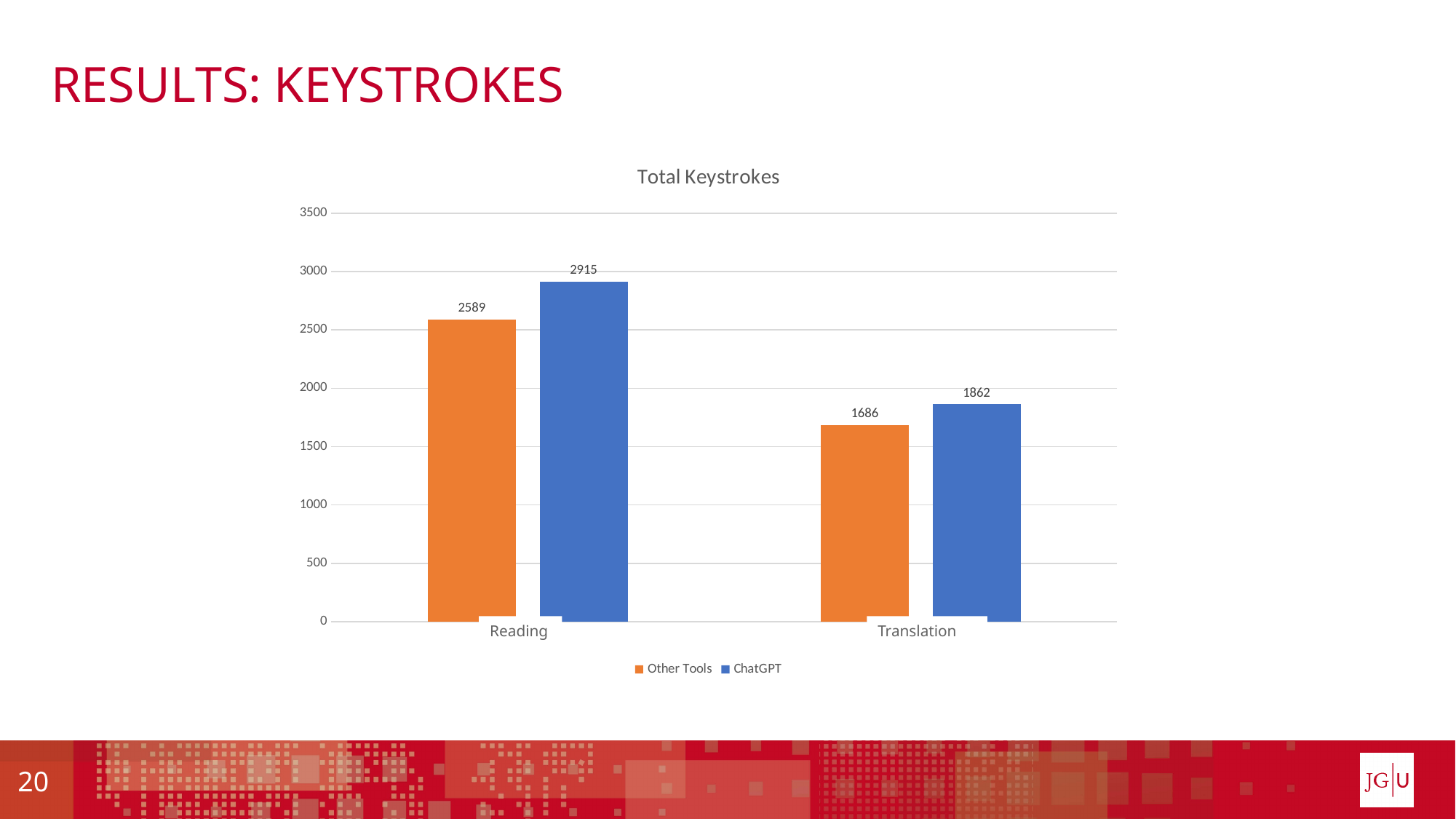
Which is larger in the Translation category, Other Tools or ChatGPT? ChatGPT What is the difference between ChatGPT and Other Tools in the Translation category? 176 What is the value for Other Tools in the Reading category? 2589 What is the value for Other Tools in the Translation category? 1686 What is the difference between ChatGPT and Other Tools in the Reading category? 326 How many series does the legend list? 2 What type of chart is shown on the slide? Bar chart Which bar has the lowest value in the chart? Other Tools, Translation What is the value for ChatGPT in the Translation category? 1862 How many categories are shown on the x axis? 2 What is the value for ChatGPT in the Reading category? 2915 Which bar has the highest value in the chart? ChatGPT, Reading